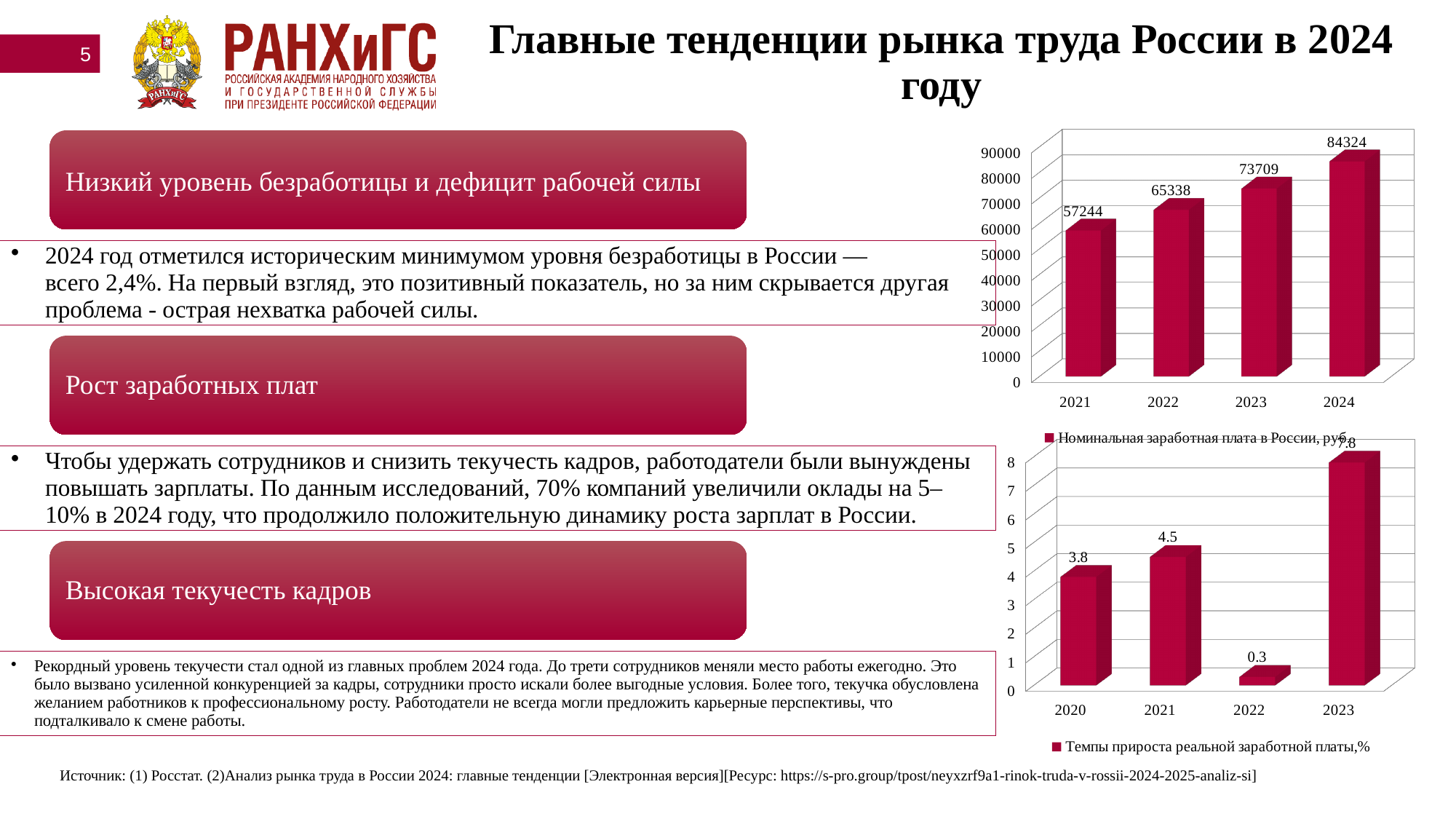
What kind of chart is the bottom chart (Темпы прироста реальной заработной платы,%)? bar chart In the bottom chart (Темпы прироста реальной заработной платы,%), what is the value for 2022? 0.3 In the top chart (Номинальная заработная плата в России, руб.), what is the value for 2021? 57244 In the bottom chart (Темпы прироста реальной заработной платы,%), which year has the lowest value? 2022 In the top chart (Номинальная заработная плата в России, руб.), what is the value for 2024? 84324 In the bottom chart (Темпы прироста реальной заработной платы,%), which is larger, the value for 2020 or the value for 2021? 2021 In the top chart (Номинальная заработная плата в России, руб.), do the values rise or fall from 2021 to 2024? rise In the top chart (Номинальная заработная плата в России, руб.), which year has the highest value? 2024 In the bottom chart (Темпы прироста реальной заработной платы,%), which year has the highest value? 2023 How many years are shown on the x axis of the top chart (Номинальная заработная плата в России, руб.)? 4 In the bottom chart (Темпы прироста реальной заработной платы,%), what is the difference between the 2021 and 2020 values? 0.7 In the top chart (Номинальная заработная плата в России, руб.), what is the difference between the 2024 and 2023 values? 10615